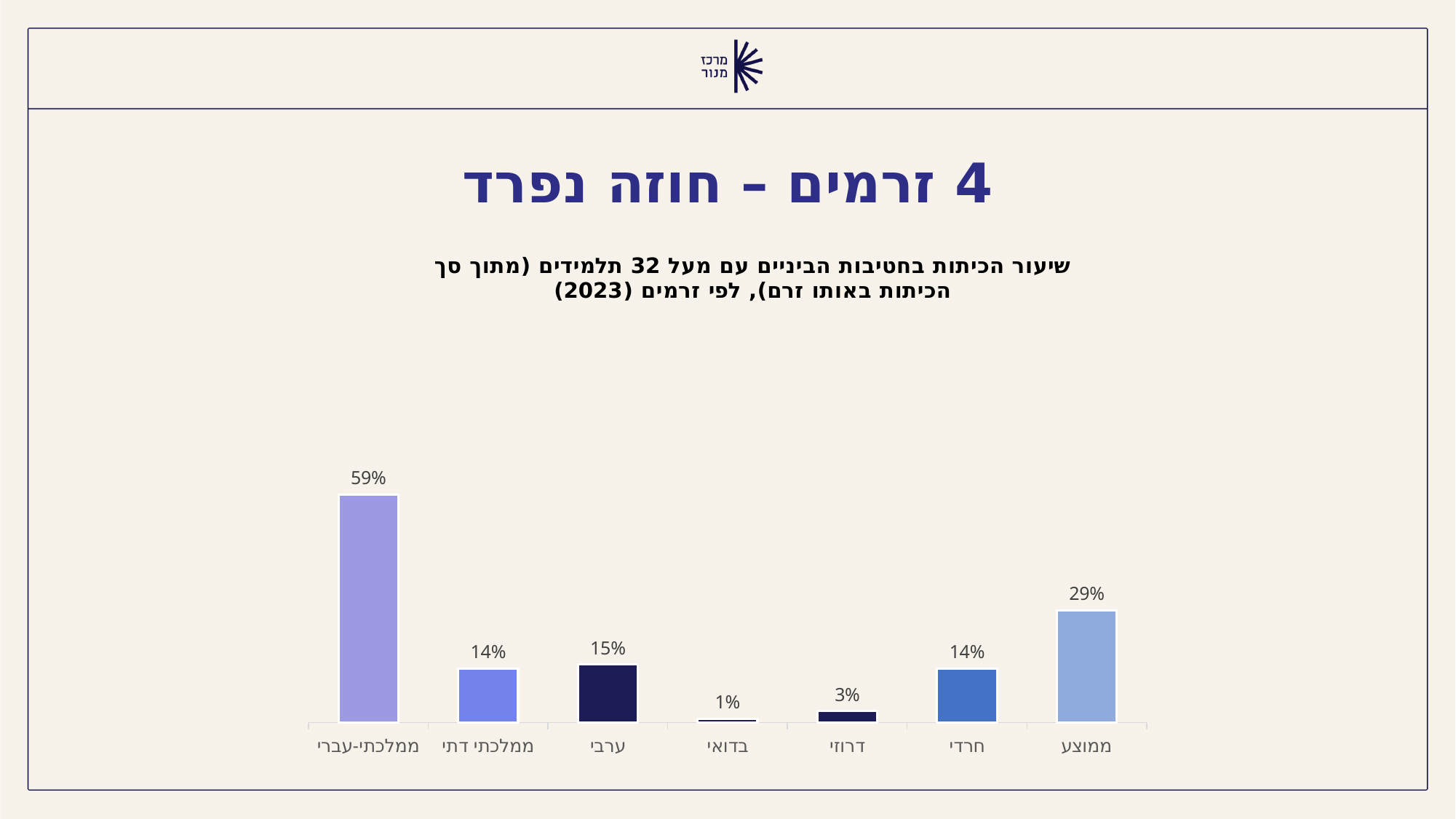
Which category has the highest value? ממלכתי-עברי What is the value for ערבי? 15% How many categories are shown on the x axis? 7 Which is larger, the value for חרדי or the value for דרוזי? חרדי What is the difference between the values for ערבי and דרוזי? 12% What is the value for דרוזי? 3% What is the value for ממוצע? 29% What kind of chart is shown on the slide? bar chart What is the difference between the values for ממלכתי-עברי and ממוצע? 30% What is the value for ממלכתי-עברי? 59% What year is given in the chart's subtitle? 2023 Which category has the lowest value? בדואי